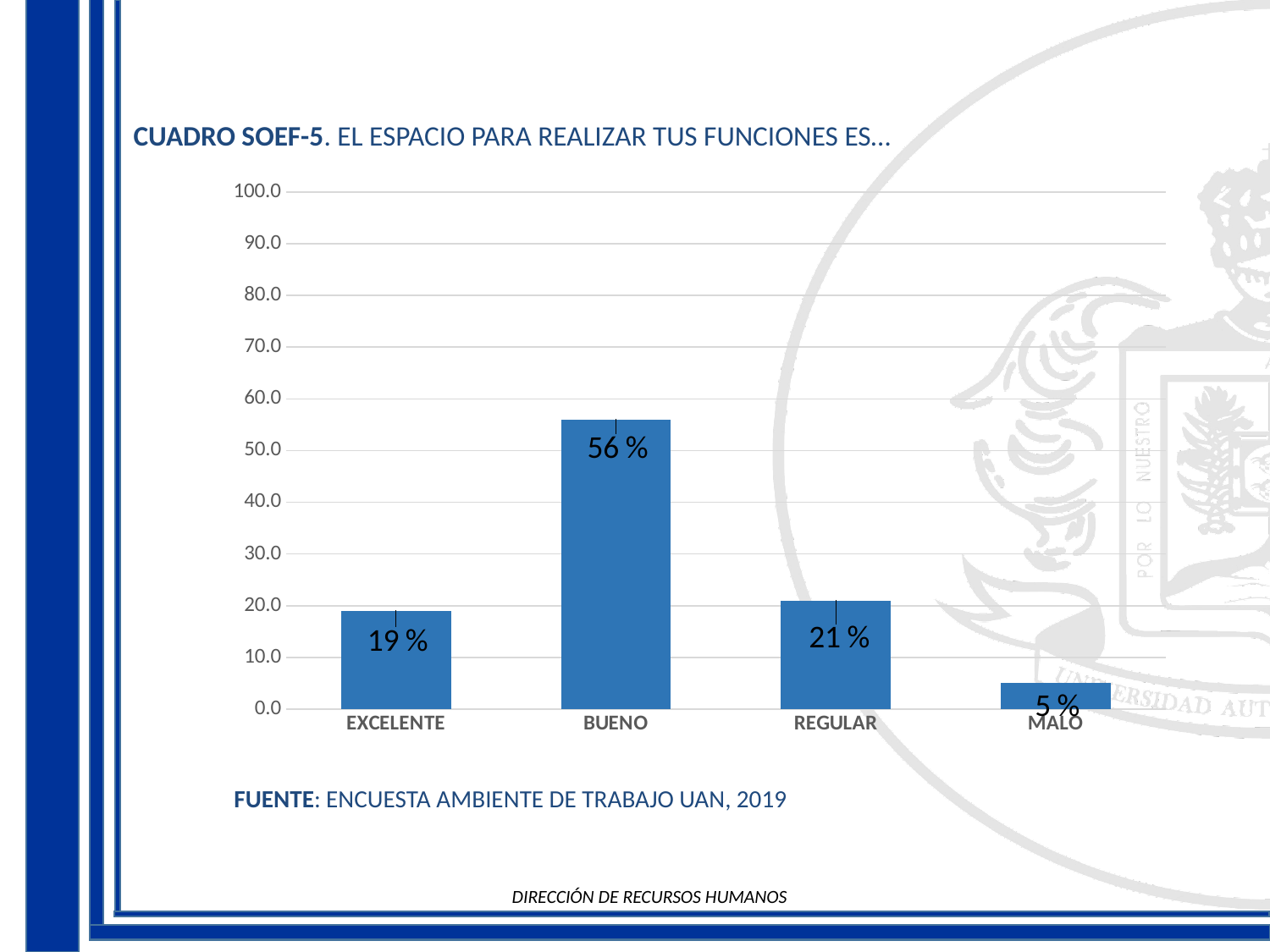
What is the value for EXCELENTE? 19 % How many categories are shown on the x axis? 4 Which category has the lowest value? MALO Is the value for BUENO greater or less than 50.0? greater What is the value for MALO? 5 % Which is larger, the value for REGULAR or the value for EXCELENTE? REGULAR What is the value for REGULAR? 21 % What kind of chart is shown on the slide? bar chart Which category has the highest value? BUENO What is the source cited below the chart? ENCUESTA AMBIENTE DE TRABAJO UAN, 2019 What is the difference between the values for BUENO and REGULAR? 35 % What is the value for BUENO? 56 %